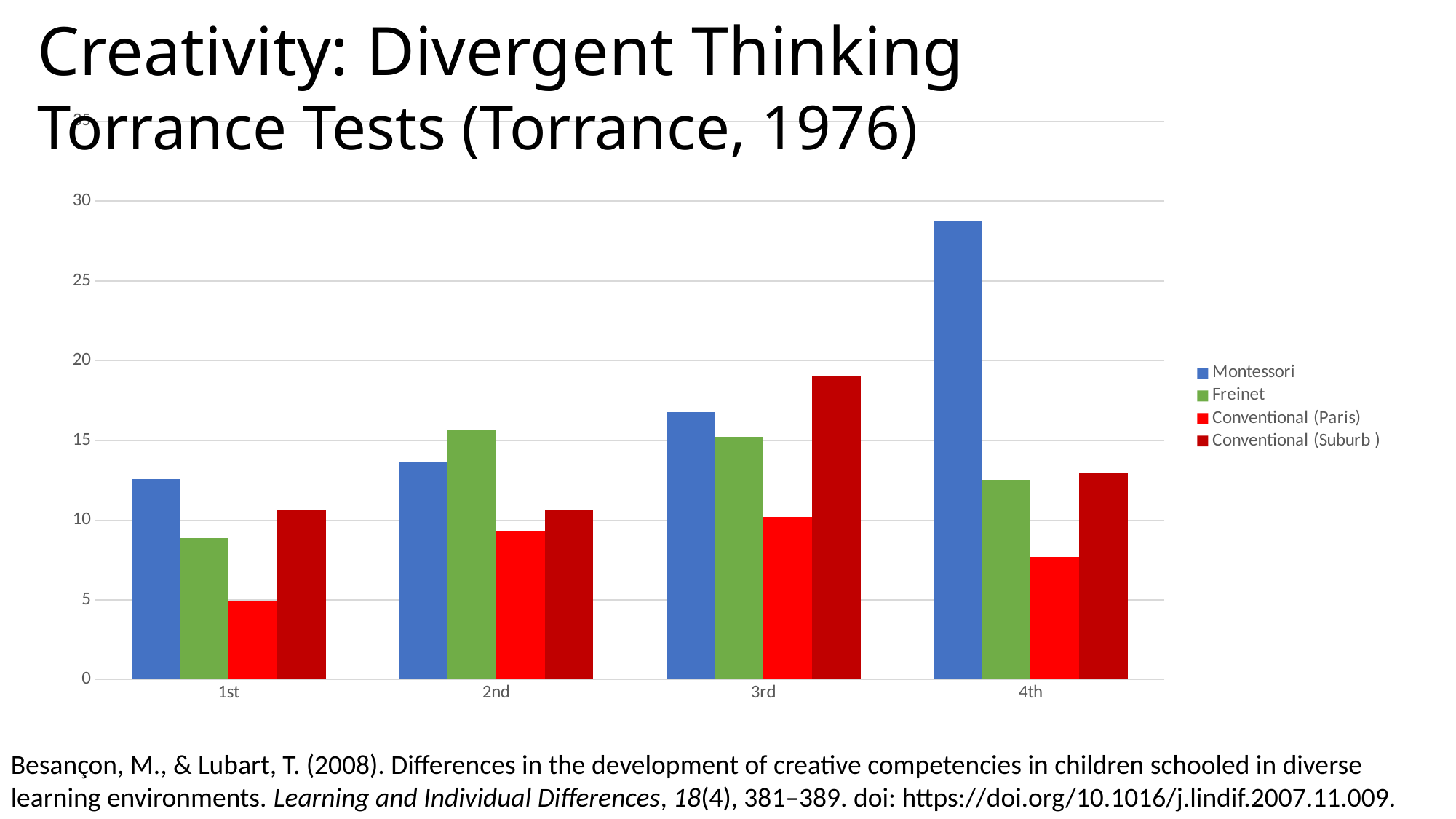
Is the Conventional (Suburb ) value for 3rd greater or less than 15? greater In which category is the Conventional (Paris) value lowest? 1st How many series does the legend list? 4 For the 4th category, which is larger: Montessori or Conventional (Suburb )? Montessori In which category is the Montessori value highest? 4th For the 2nd category, which is larger: Montessori or Freinet? Freinet Do the Montessori values rise or fall from 1st to 4th? rise What kind of chart is shown on the slide? bar chart How many categories are shown on the x axis? 4 Is the Montessori value for 4th greater or less than 25? greater Which series is shown in green in the legend? Freinet